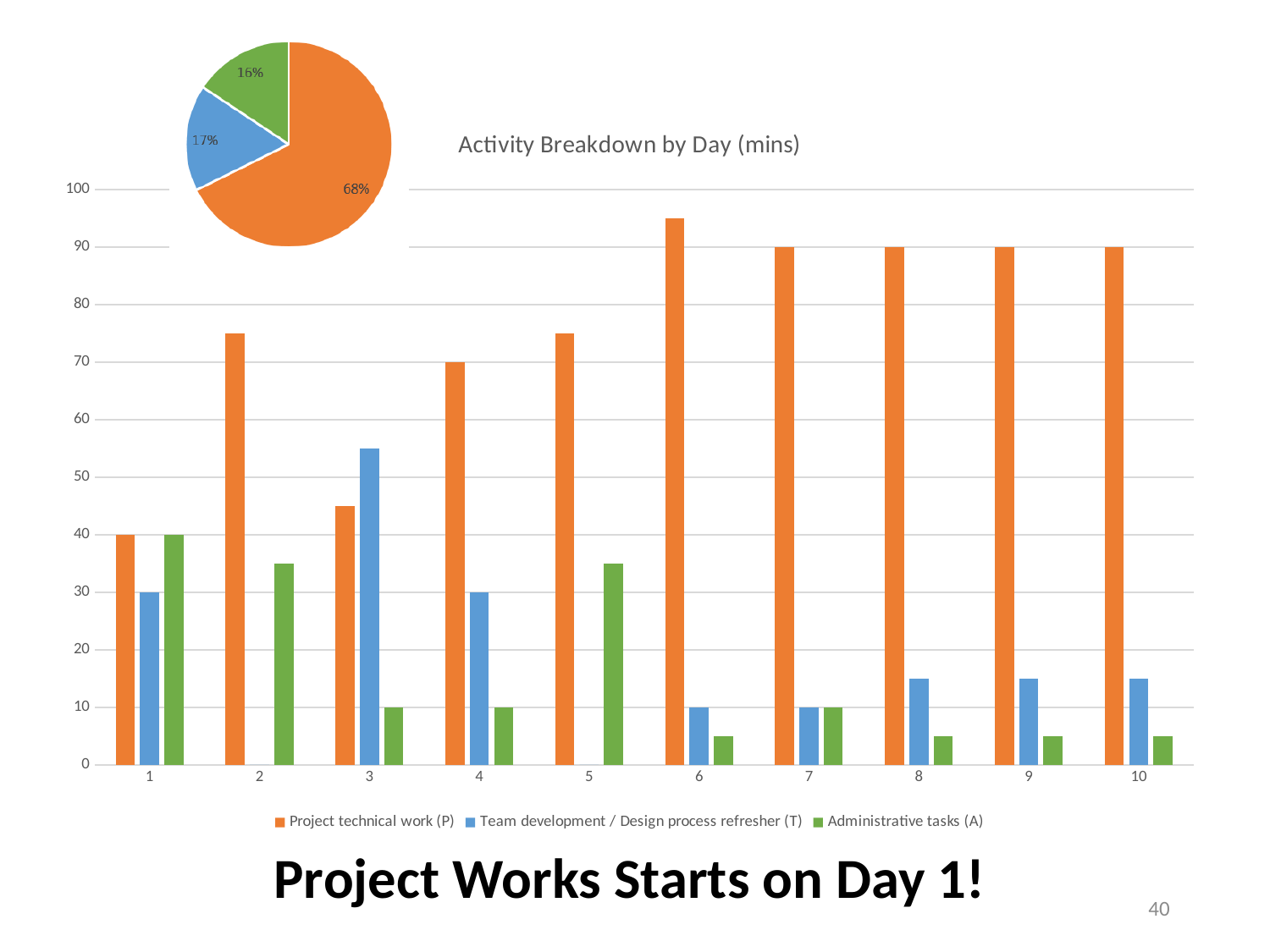
In the Activity Breakdown by Day chart, is the value for Project technical work (P) on day 2 greater or less than 70? greater How many series does the legend of the Activity Breakdown by Day chart list? 3 In the Activity Breakdown by Day chart, on which day is Team development / Design process refresher (T) highest? 3 In the Activity Breakdown by Day chart, on day 3, which is larger: Project technical work (P) or Team development / Design process refresher (T)? Team development / Design process refresher (T) In the Activity Breakdown by Day chart, is the value for Administrative tasks (A) on day 5 greater or less than 30? greater In the Activity Breakdown by Day chart, on which day is Project technical work (P) highest? 6 In the Activity Breakdown by Day chart, what is the value for Project technical work (P) on day 4? 70 In the pie chart at the top left of the slide, what percentage does the largest slice show? 68% In the Activity Breakdown by Day chart, what is the value for Project technical work (P) on day 1? 40 How many days are shown on the x axis of the Activity Breakdown by Day chart? 10 In the Activity Breakdown by Day chart, what is the difference between Project technical work (P) and Team development / Design process refresher (T) on day 4? 40